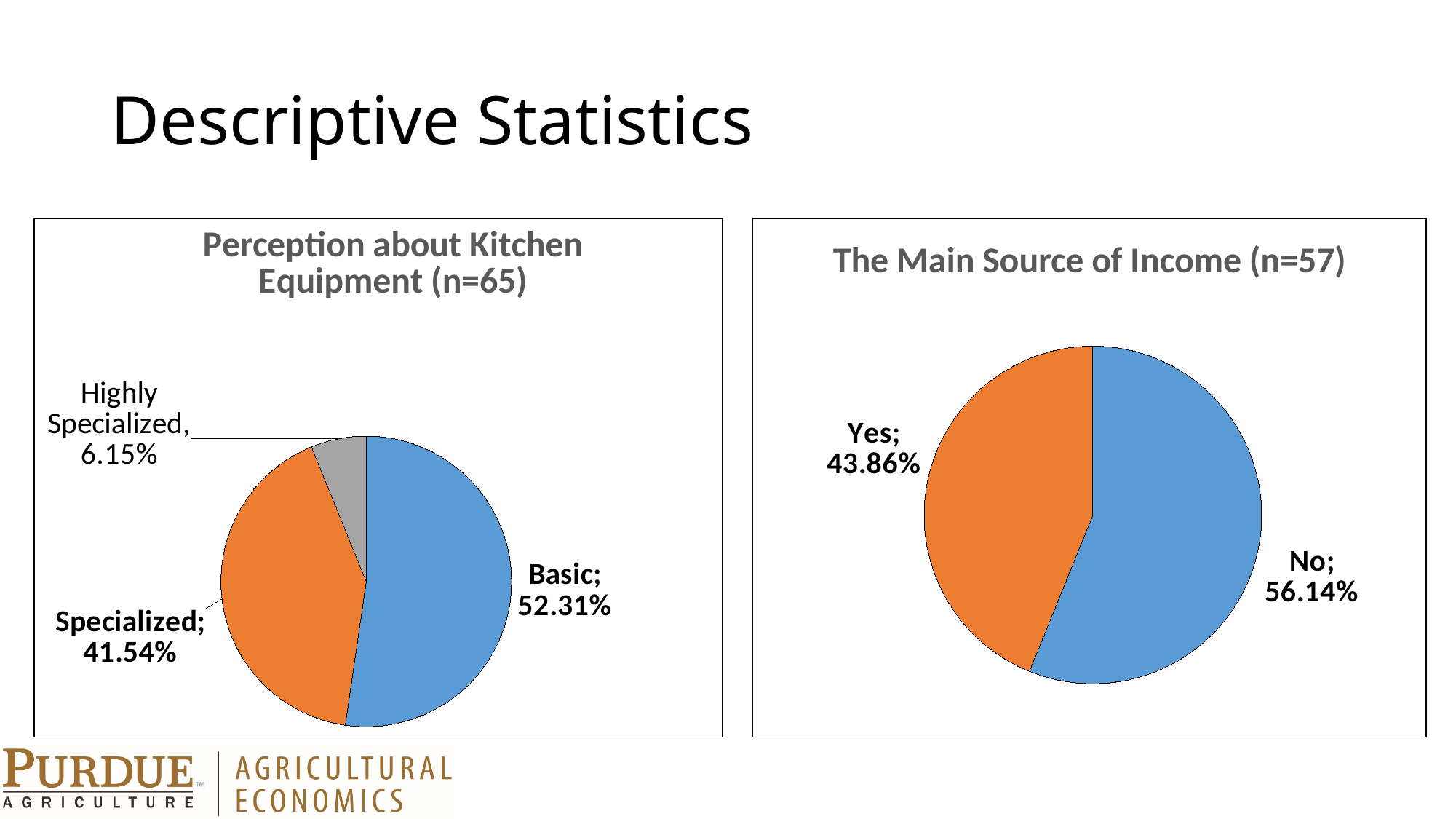
In the 'Perception about Kitchen Equipment (n=65)' chart, what share of the pie is Basic? 52.31% In the 'Perception about Kitchen Equipment (n=65)' chart, what is the value for Specialized? 41.54% In 'The Main Source of Income (n=57)' chart, what is the value for No? 56.14% In 'The Main Source of Income (n=57)' chart, which is larger, Yes or No? No What kind of chart is 'The Main Source of Income (n=57)'? Pie chart In the 'Perception about Kitchen Equipment (n=65)' chart, what is the difference between the Basic and Specialized shares? 10.77% In the 'Perception about Kitchen Equipment (n=65)' chart, which category has the largest slice? Basic In the 'Perception about Kitchen Equipment (n=65)' chart, which category has the smallest slice? Highly Specialized In the 'Perception about Kitchen Equipment (n=65)' chart, what is the value for Highly Specialized? 6.15% In 'The Main Source of Income (n=57)' chart, what colour is the No slice? Blue In 'The Main Source of Income (n=57)' chart, what share of the pie is Yes? 43.86% In the 'Perception about Kitchen Equipment (n=65)' chart, how many categories are shown? 3